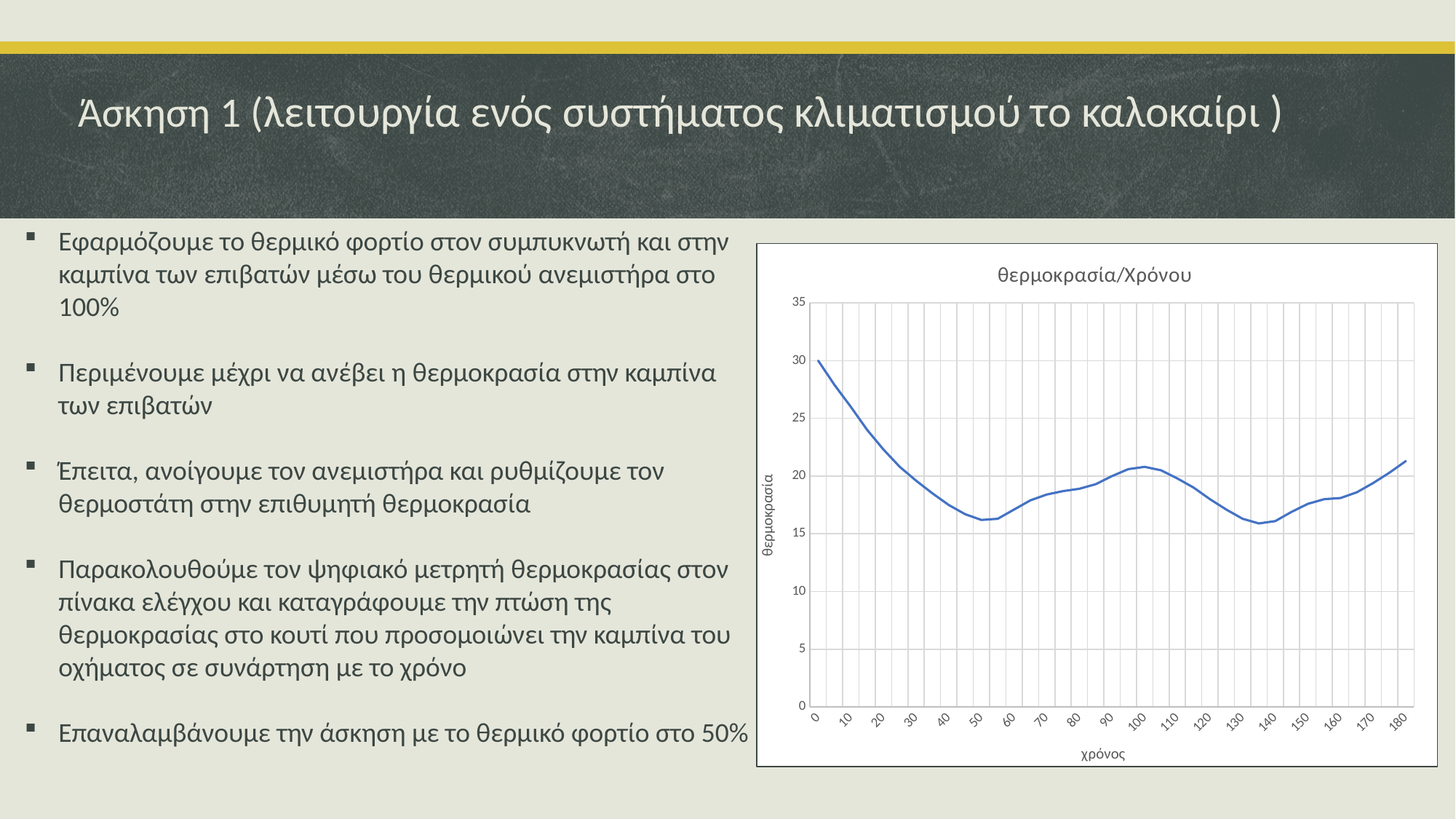
Is the temperature at χρόνος 50 greater or less than 20? less Is the temperature at χρόνος 10 greater or less than 25? greater What is the label of the x axis of the chart? χρόνος What is the temperature value at χρόνος 0? 30 At which χρόνος value is the temperature highest? 0 Does the temperature rise or fall between χρόνος 140 and χρόνος 180? rise What kind of chart is shown on the slide? line chart Is the temperature at χρόνος 100 greater or less than 20? greater What is the title of the chart? θερμοκρασία/Χρόνου Which is larger, the temperature at χρόνος 0 or at χρόνος 100? χρόνος 0 Does the temperature rise or fall between χρόνος 0 and χρόνος 50? fall